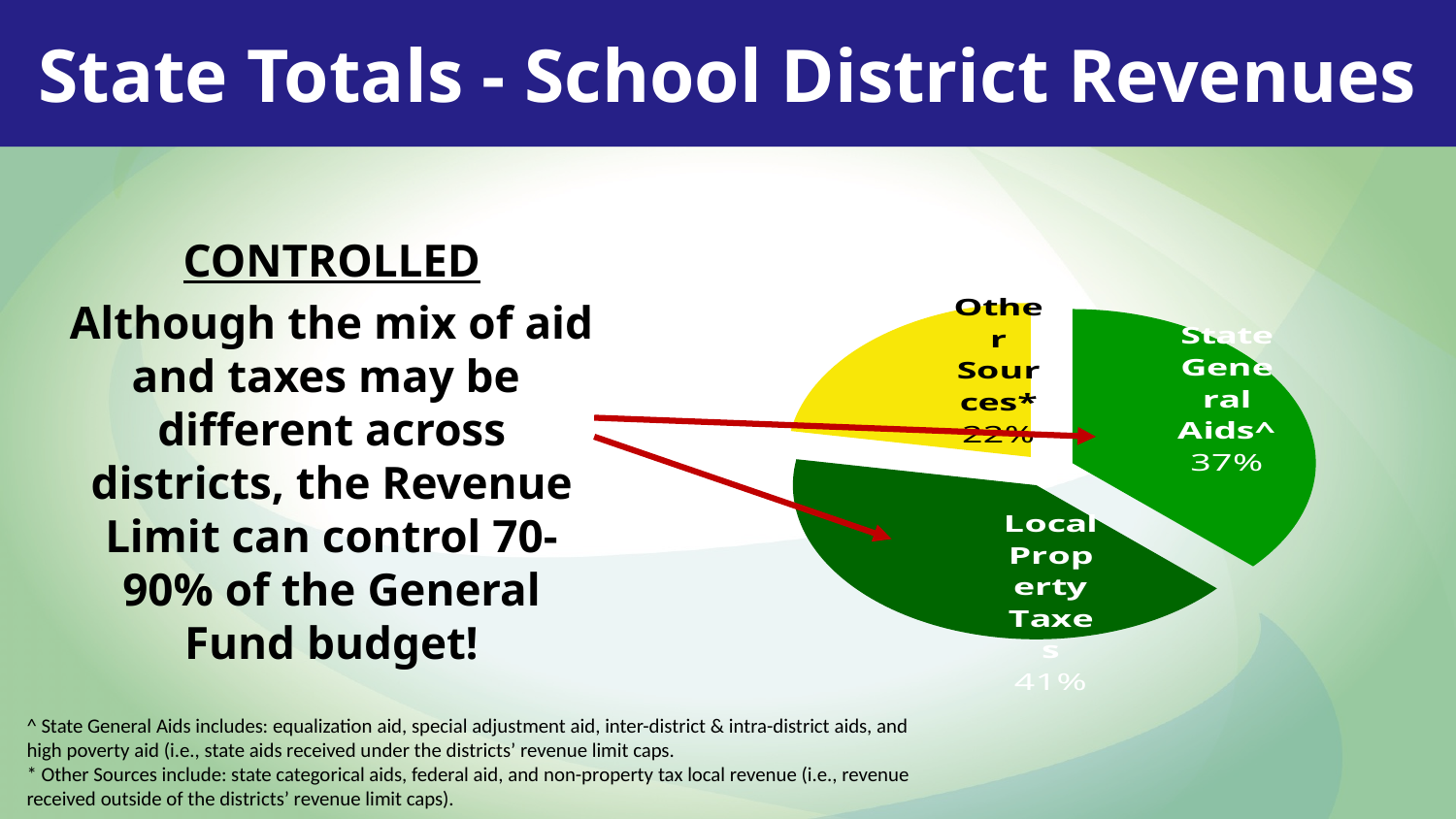
What share of school district revenues comes from Other Sources? 22% What colour is the Other Sources slice of the pie? yellow What kind of chart is shown on the slide? pie chart What share of school district revenues comes from Local Property Taxes? 41% What is the difference in percentage points between Local Property Taxes and State General Aids? 4 Which revenue source has the smallest share of the pie? Other Sources Which revenue source has the largest share of the pie? Local Property Taxes What is the combined share of Local Property Taxes and State General Aids? 78% What share of school district revenues comes from State General Aids? 37% Which is larger, the share for State General Aids or the share for Other Sources? State General Aids What is the difference in percentage points between State General Aids and Other Sources? 15 How many slices does the pie chart have? 3